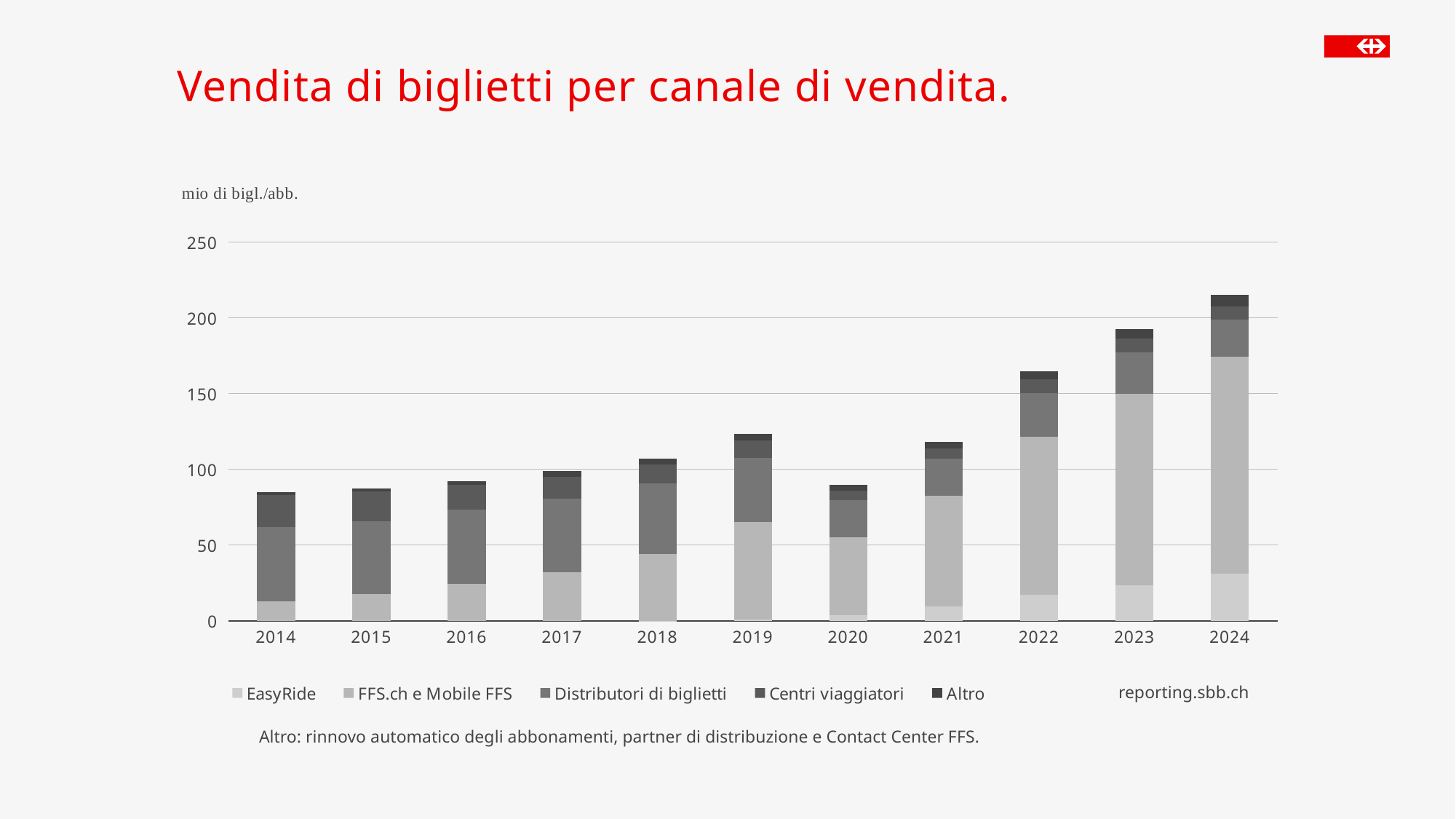
Is the total for 2022 greater or less than 150? greater What is the title of the chart on the slide? Vendita di biglietti per canale di vendita. Is the total for 2024 greater or less than 200? greater Which year has the highest total stacked bar? 2024 What unit is indicated above the chart's y axis? mio di bigl./abb. How many series does the chart legend list? 5 Is the total for 2020 greater or less than 100? less What kind of chart is shown on the slide? Stacked bar chart Which year has the larger total bar, 2021 or 2023? 2023 How many years are shown on the x axis of the chart? 11 Do the total bar heights generally rise or fall from 2014 to 2024? rise